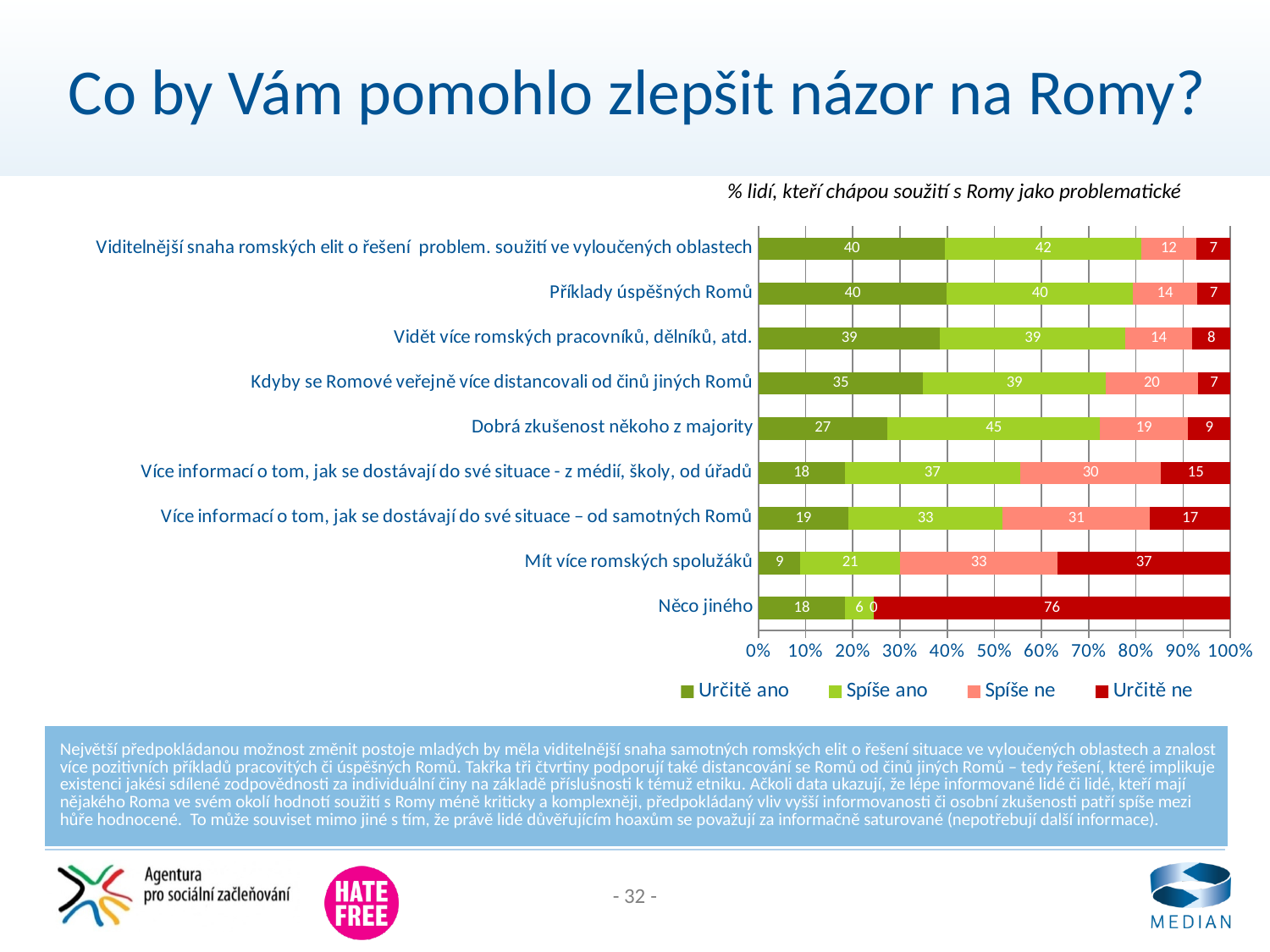
What kind of chart is shown on the slide? Stacked bar chart What is the difference between the "Spíše ne" values for "Mít více romských spolužáků" and "Příklady úspěšných Romů"? 19 How many series does the legend list? 4 What is the "Určitě ano" value for "Příklady úspěšných Romů"? 40 What is the "Spíše ne" value for "Kdyby se Romové veřejně více distancovali od činů jiných Romů"? 20 How many categories are shown on the chart? 9 Which category has the highest "Určitě ne" value? Něco jiného What is the "Spíše ano" value for "Dobrá zkušenost někoho z majority"? 45 Which is larger: the "Určitě ano" value for "Dobrá zkušenost někoho z majority" or for "Více informací o tom, jak se dostávají do své situace – od samotných Romů"? Dobrá zkušenost někoho z majority What is the total of the stacked bar for "Mít více romských spolužáků"? 100 Which category has the lowest "Určitě ano" value? Mít více romských spolužáků What is the "Určitě ne" value for "Mít více romských spolužáků"? 37